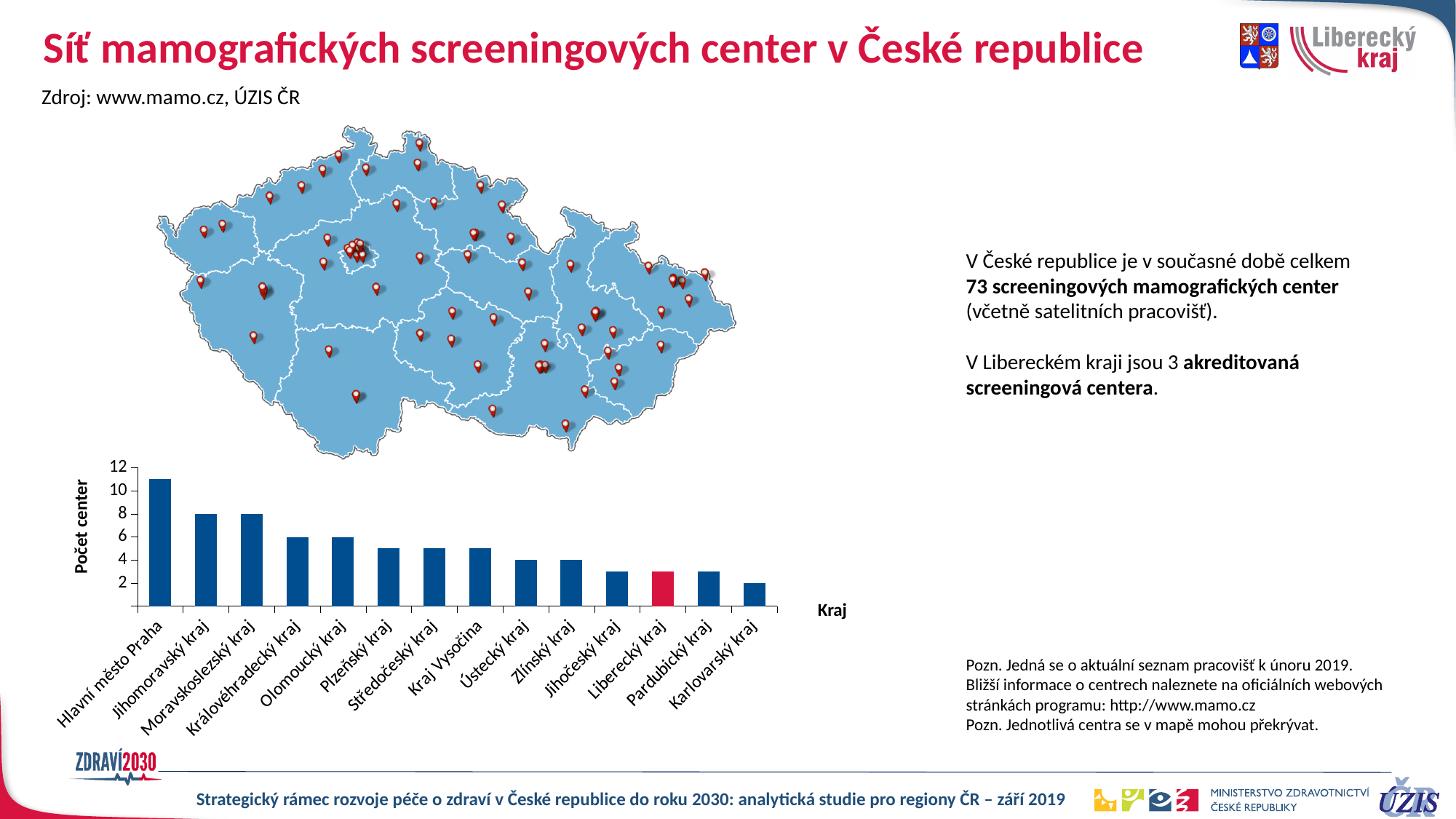
What is the number of centers for Karlovarský kraj? 2 What is the number of centers for Královéhradecký kraj? 6 How many kraje (categories) are shown on the x axis of the bar chart? 14 Which kraj is highlighted with a red bar in the chart? Liberecký kraj Which kraj has the lowest number of centers in the bar chart? Karlovarský kraj What is the difference between the number of centers in Jihomoravský kraj and Karlovarský kraj? 6 What is the number of centers for Jihomoravský kraj? 8 What kind of chart is shown at the bottom left of the slide? bar chart Which kraj has the highest number of centers in the bar chart? Hlavní město Praha Is the value for Hlavní město Praha greater or less than 10? greater How many accredited screening centers does Liberecký kraj have according to the slide? 3 Do the bar values rise or fall from left to right along the x axis? fall